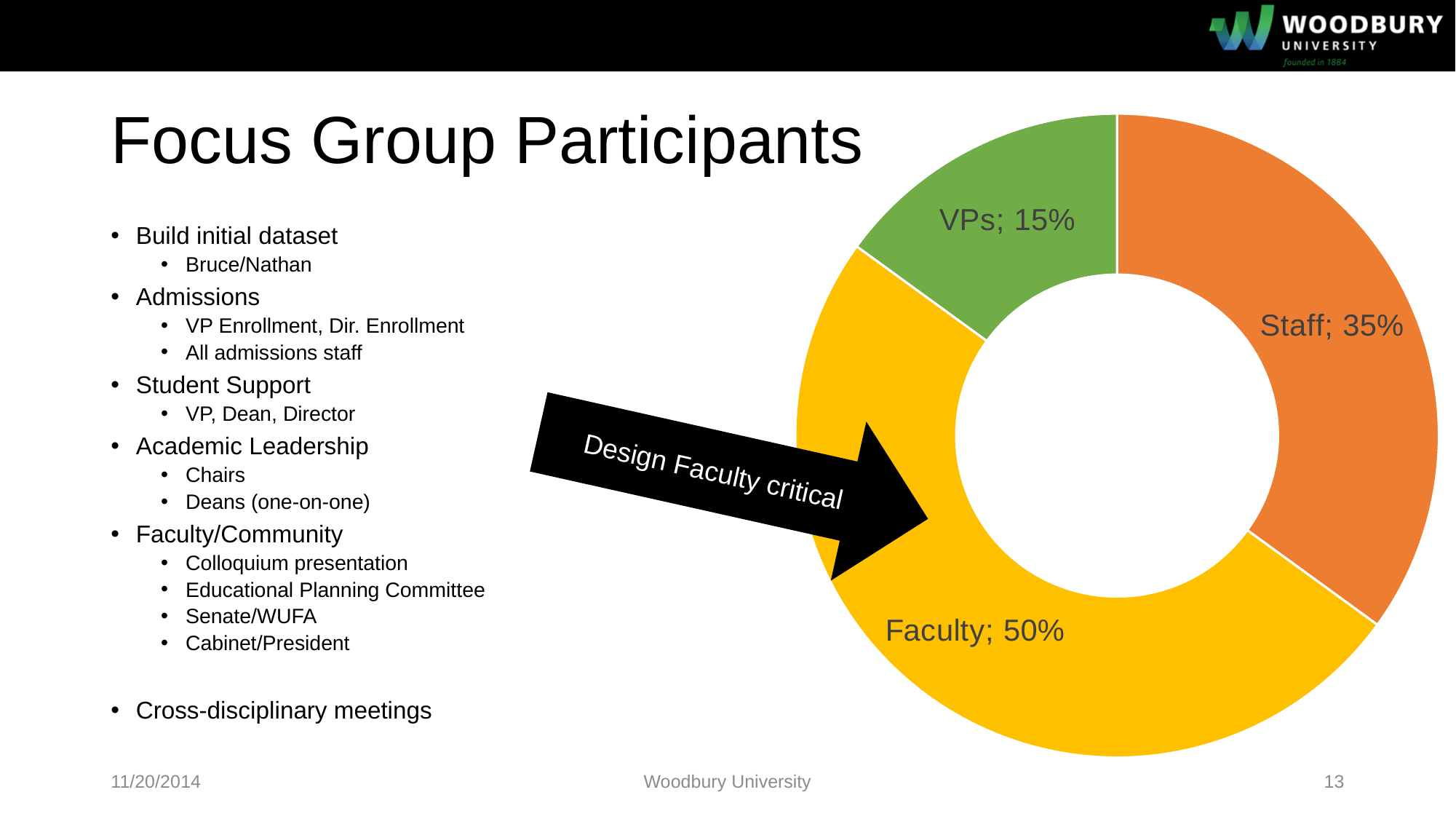
What is the difference in percentage points between the Staff share and the VPs share? 20 What share of focus group participants are Faculty? 50% What kind of chart is shown on the slide? Doughnut (pie) chart What does the arrow pointing at the chart say? Design Faculty critical What colour is the Faculty segment of the chart? Yellow What share of focus group participants are Staff? 35% Which is larger, the Staff share or the VPs share? Staff What share of focus group participants are VPs? 15% How many groups are shown in the chart? 3 Which group has the smallest share of the chart? VPs Which group has the largest share of the chart? Faculty What is the difference in percentage points between the Faculty share and the Staff share? 15